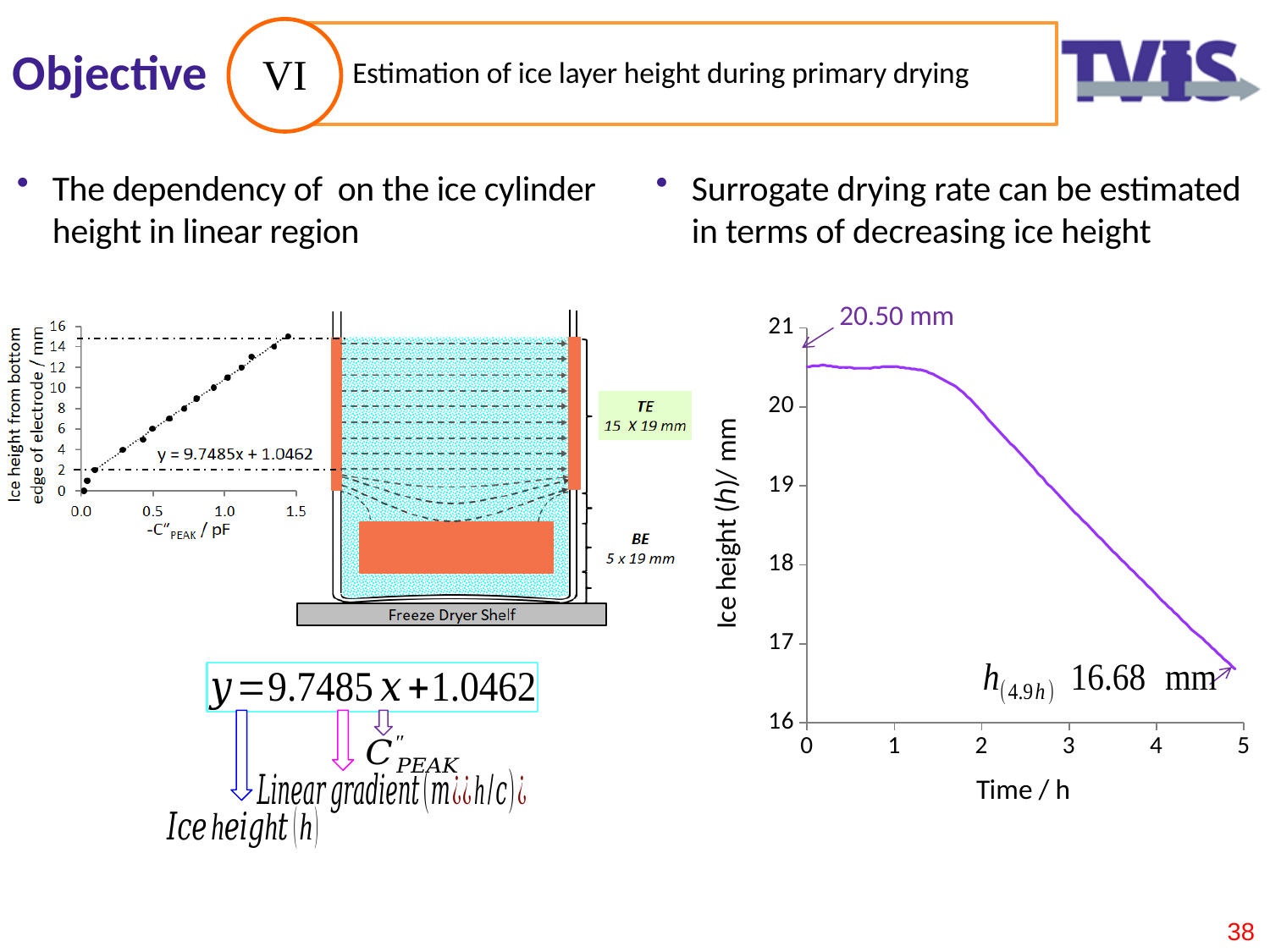
On the right chart (ice height vs time), does the ice height rise or fall as time increases? fall On the right chart (ice height vs time), is the ice height at 4 h greater or less than 18? less On the right chart (ice height vs time), what is the ice height at the start of drying, as labelled on the chart? 20.50 mm On the left chart (ice height vs -C''PEAK), what is the trendline equation shown? y = 9.7485x + 1.0462 On the left chart (ice height vs -C''PEAK), does the ice height rise or fall as -C''PEAK increases? rise On the right chart (ice height vs time), what is the label of the x axis? Time / h On the right chart (ice height vs time), what is the ice height at 4.9 h, as labelled on the chart? 16.68 mm On the right chart (ice height vs time), is the ice height at 1 h greater or less than 20? greater On the left chart (ice height vs -C''PEAK), is the ice height at -C''PEAK = 1.0 pF greater or less than 10? greater What kind of chart is the right chart (ice height vs time)? line chart On the right chart (ice height vs time), what is the difference between the labelled starting ice height and the labelled ice height at 4.9 h? 3.82 mm